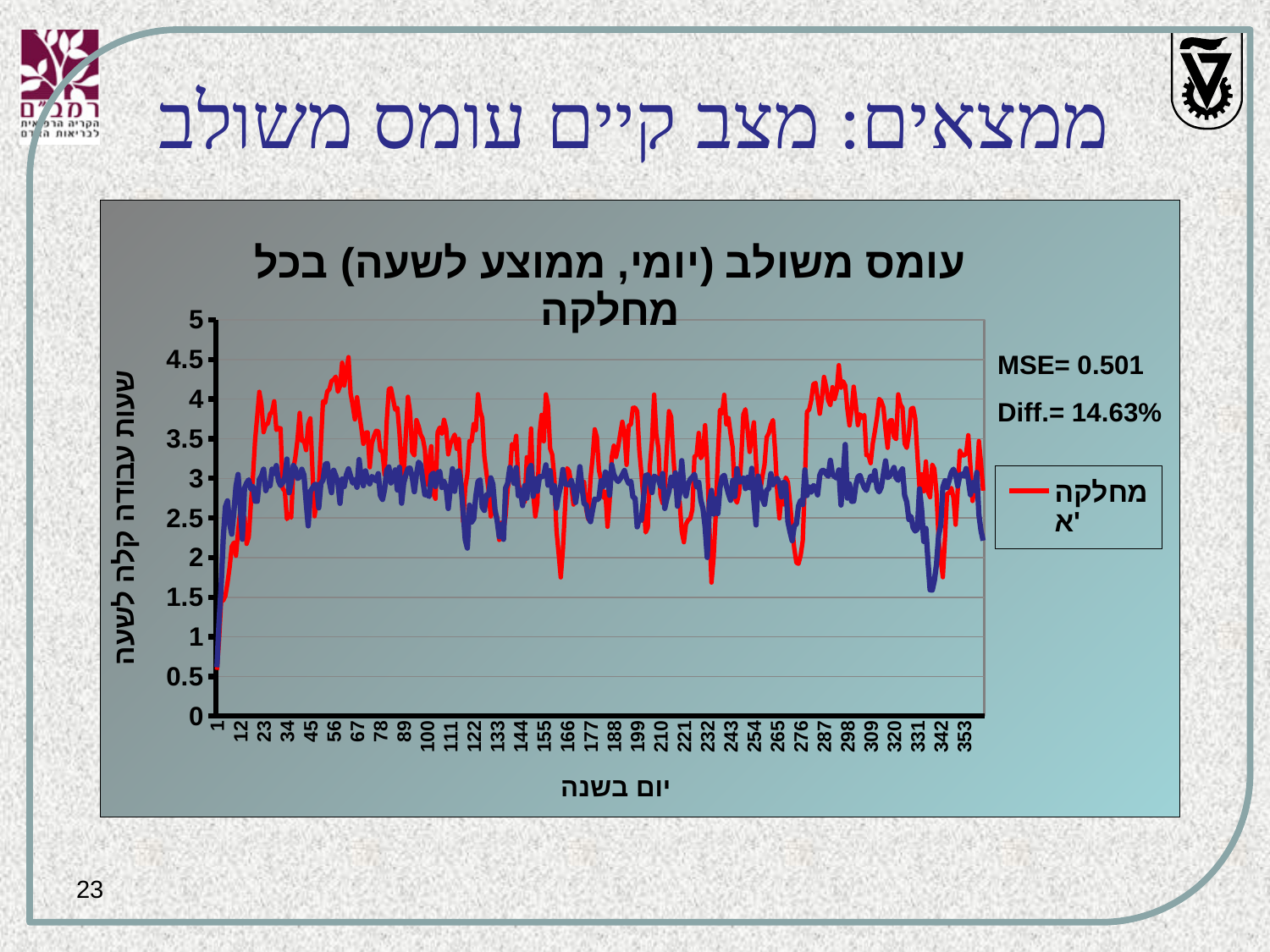
Is the peak of the red line around day 56–67 greater or less than 4? greater What is the label of the x axis of the chart? יום בשנה Is the value of the blue line around day 100 greater or less than 2.5? greater Do the lines rise or fall over the first few days of the year shown on the x axis? rise What is the highest tick value shown on the y axis? 5 What is the lowest tick value shown on the y axis? 0 How many entries does the chart's legend list? 1 What kind of chart is shown on the slide? line chart Is the value of the blue line at day 1 greater or less than 1? less What MSE value is printed next to the chart? 0.501 What is the title of the chart? עומס משולב (יומי, ממוצע לשעה) בכל מחלקה